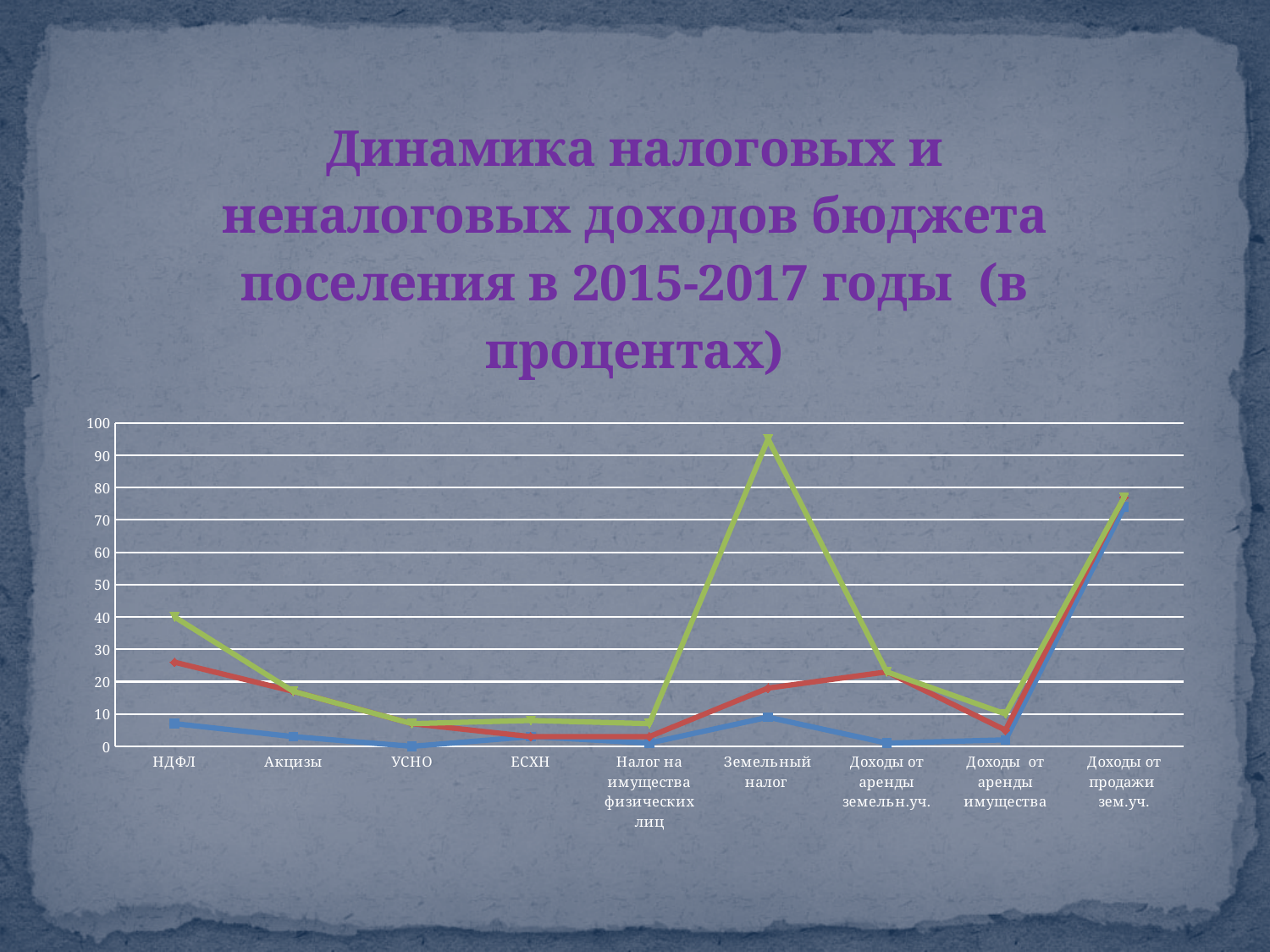
For Земельный налог, which line has the larger value, the blue line or the red line? the red line How many categories are shown along the x axis of the chart? 9 Is the value of the red line for Доходы от аренды земельн.уч. greater or less than 20? greater What kind of chart is shown on the slide? line chart Is the value of the green line for НДФЛ greater or less than 30? greater For the green line, which category has the highest value? Земельный налог Is the value of the blue line for Доходы от продажи зем.уч. greater or less than 70? greater For НДФЛ, which line has the larger value, the green line or the red line? the green line How many lines (series) are plotted on the chart? 3 Does the green line rise or fall from НДФЛ to УСНО? fall